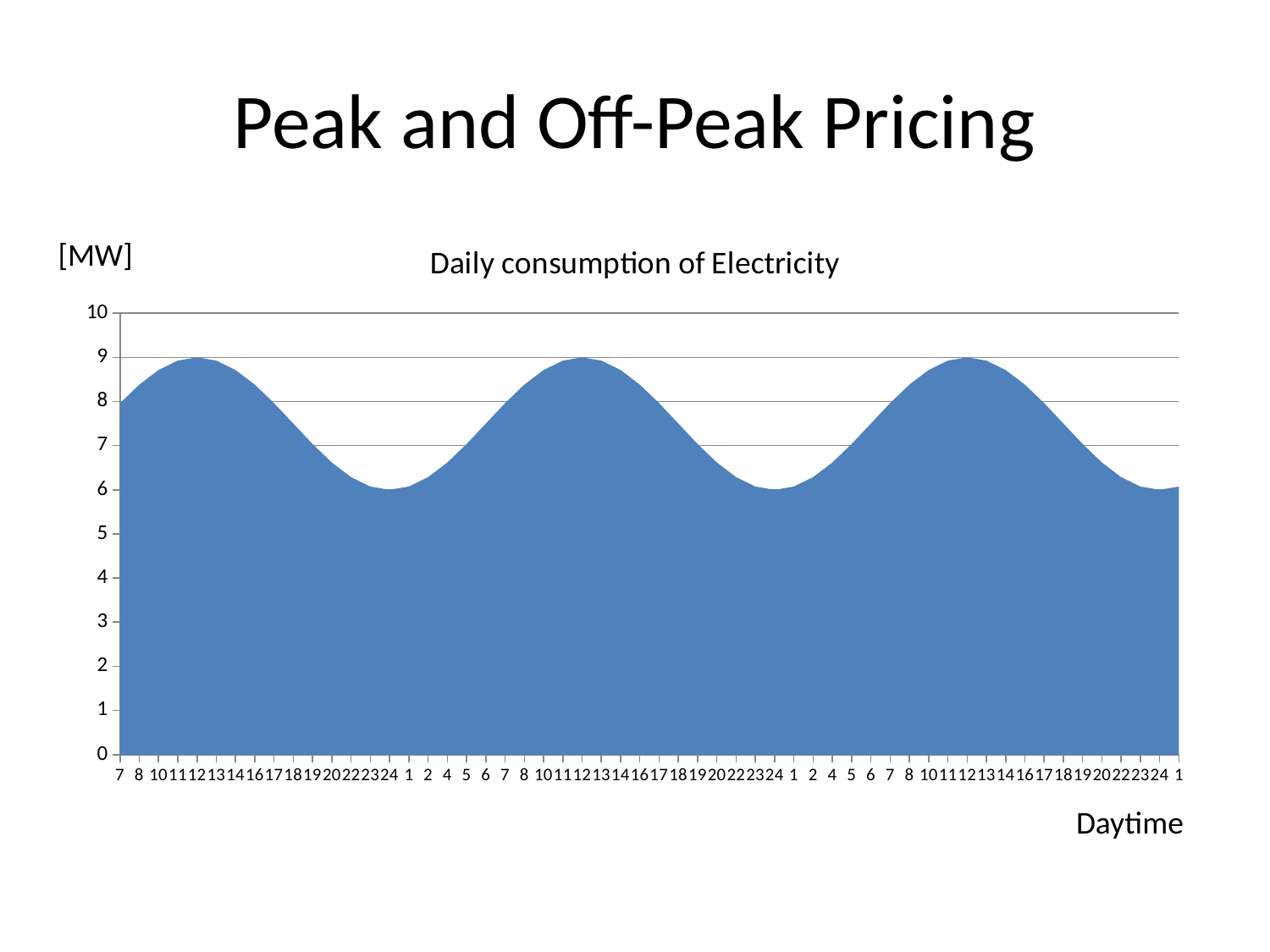
Do the values rise or fall from 12 to 24 in the first cycle? fall Is the value at the peaks greater or less than 10? less What unit is shown for the vertical axis of the chart? [MW] How many peaks does the consumption curve show across the x axis? 3 Is the value at the first x-axis point (7) greater or less than 7? greater Is the value at the first trough (around 24) greater or less than 7? less Do the values rise or fall from 7 to 12 at the start of the x axis? rise What kind of chart is shown on the slide? area chart What is the title of the chart? Daily consumption of Electricity